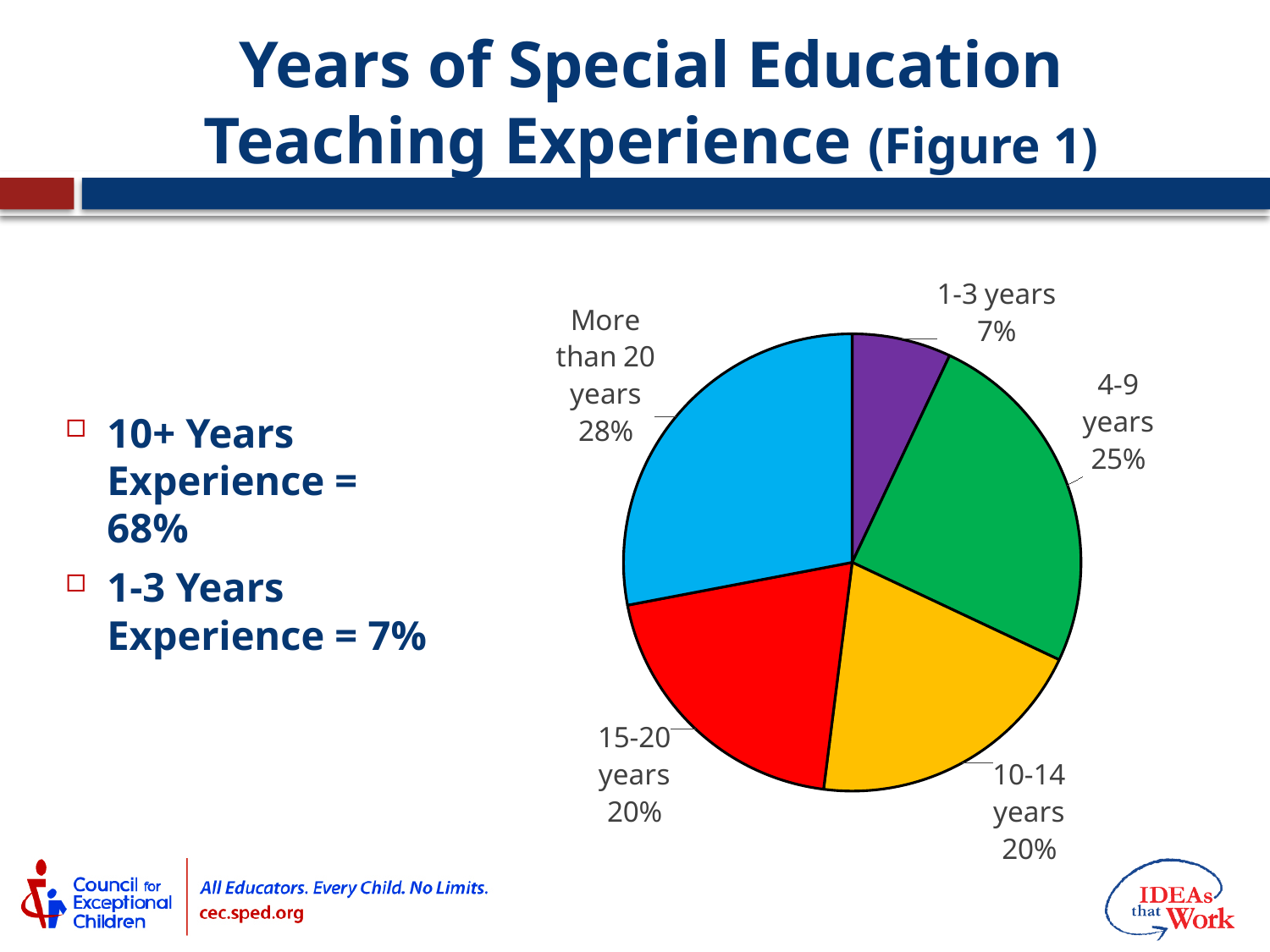
What is the combined share of the "10-14 years" and "15-20 years" slices? 40% What percentage is shown for the "1-3 years" slice? 7% What percentage is shown for the "4-9 years" slice? 25% Which category has the smallest slice of the pie? 1-3 years What colour is the "15-20 years" slice? Red What share of the pie is labelled "More than 20 years"? 28% What is the difference in percentage points between the "More than 20 years" slice and the "1-3 years" slice? 21 Which slice is larger, "4-9 years" or "15-20 years"? 4-9 years Which category has the largest slice of the pie? More than 20 years How many slices does the pie chart have? 5 What is the title of the chart on the slide? Years of Special Education Teaching Experience (Figure 1) What kind of chart is shown on the slide? Pie chart